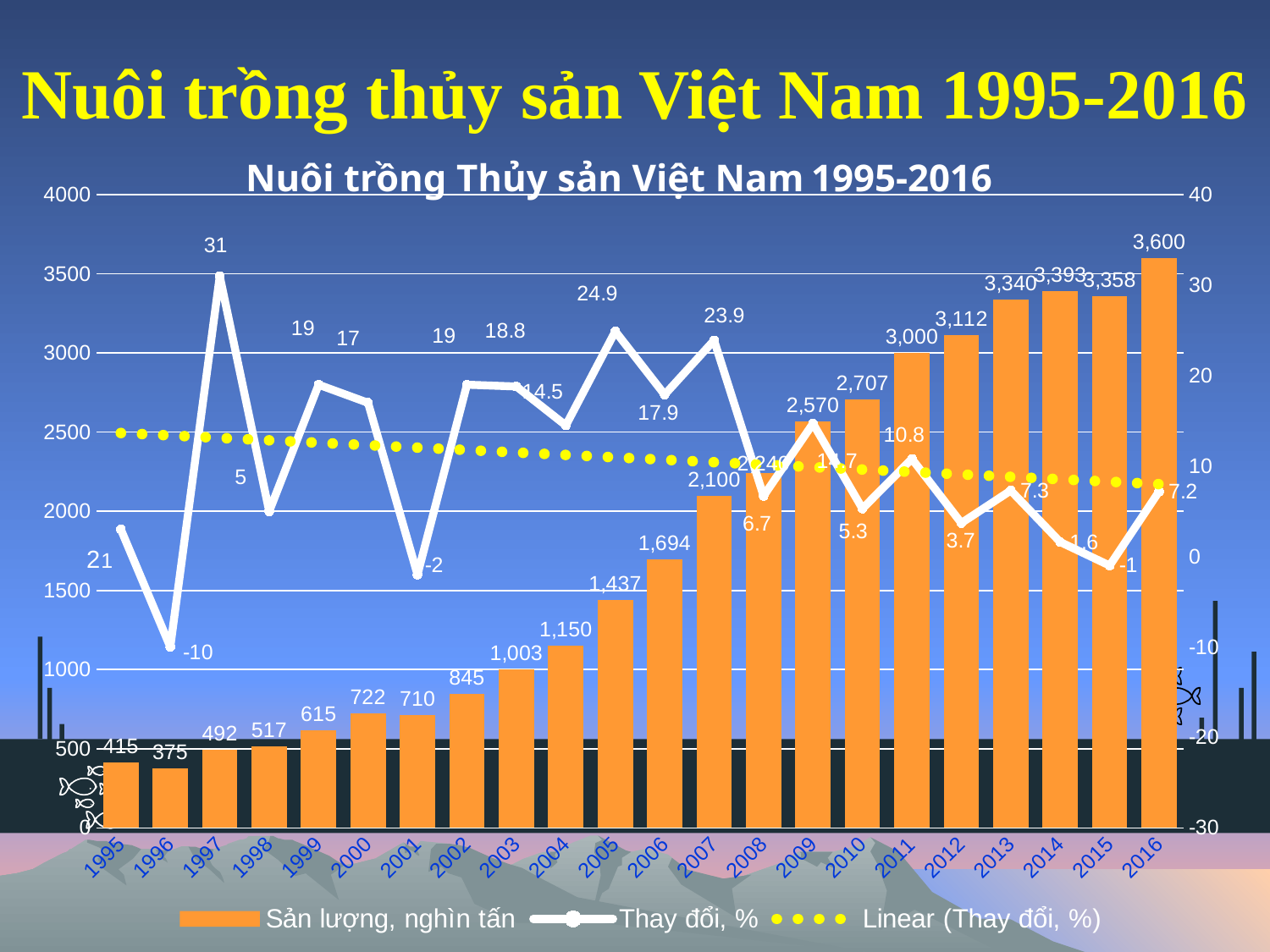
How many years are shown on the x axis? 22 Which year has the lowest production (Sản lượng, nghìn tấn)? 1996 What is the production value (Sản lượng, nghìn tấn) for 2016? 3,600 What is the percentage change (Thay đổi, %) for 1997? 31 Which year has the highest production (Sản lượng, nghìn tấn)? 2016 What is the difference in production (Sản lượng, nghìn tấn) between 2016 and 2015? 242 What is the production value (Sản lượng, nghìn tấn) for 2005? 1,437 What is the title of the chart? Nuôi trồng Thủy sản Việt Nam 1995-2016 Which year has higher production (Sản lượng, nghìn tấn), 2014 or 2015? 2014 Which year has the lowest percentage change (Thay đổi, %)? 1996 How many series does the legend list? 3 What is the percentage change (Thay đổi, %) for 2015? -1